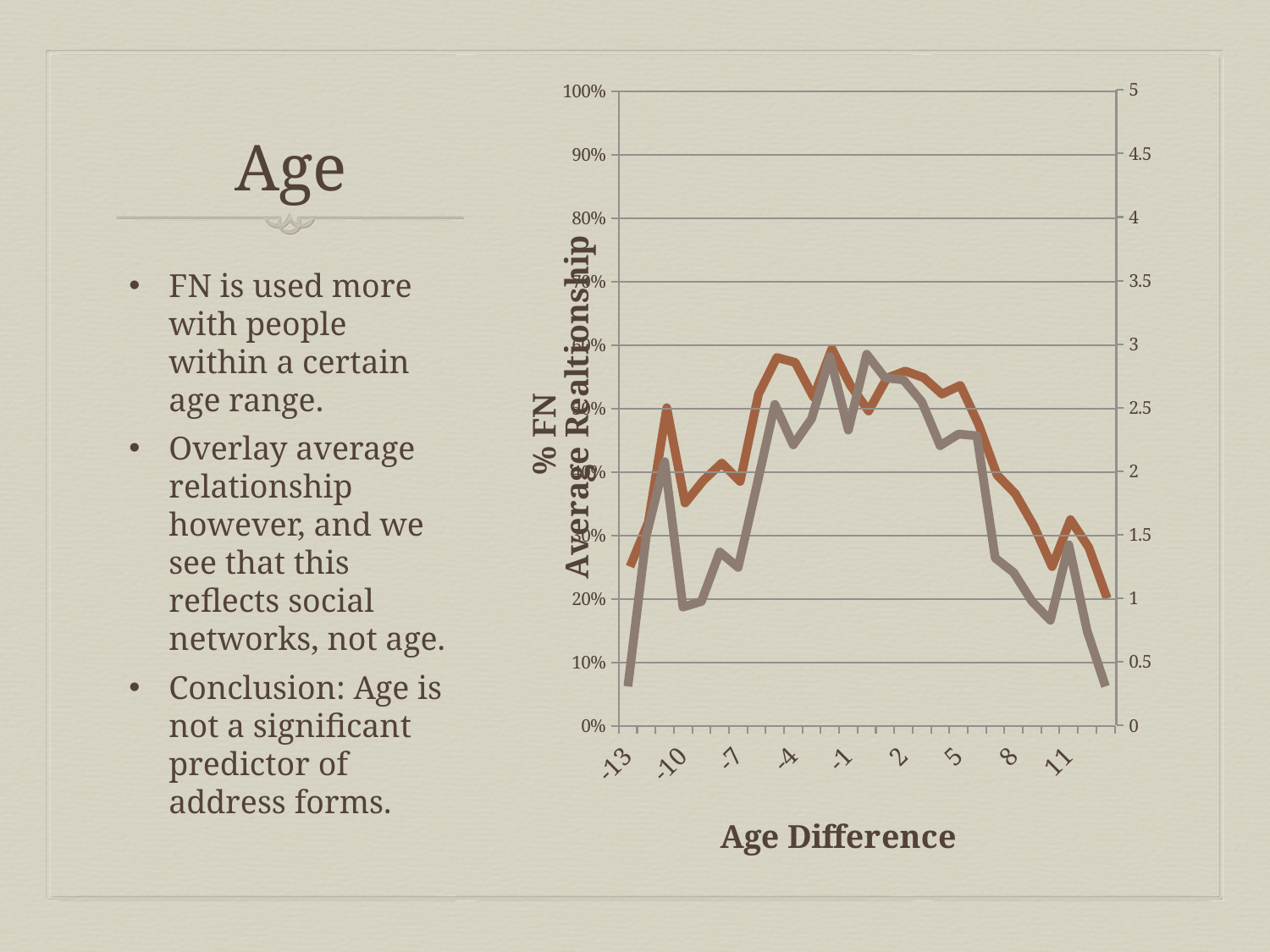
How many lines are plotted on the chart? 2 What is the title of the x axis of the chart? Age Difference What is the leftmost tick label on the x axis of the chart? -13 At the leftmost point (-13), is the gray line greater or less than 10% on the left axis? less At the leftmost point (-13), which line is higher, the orange line or the gray line? the orange line What is the rightmost tick label on the x axis of the chart? 11 Is the highest point of the orange line greater or less than 50% on the left axis? greater What is the highest value shown on the left vertical axis of the chart? 100% At the leftmost point (-13), is the orange line greater or less than 20% on the left axis? greater What kind of chart is shown on the slide? line chart What is the highest value shown on the right vertical axis of the chart? 5 Do the lines on the chart generally rise, fall, or rise and then fall as the age difference increases from -13 to the right end? rise and then fall